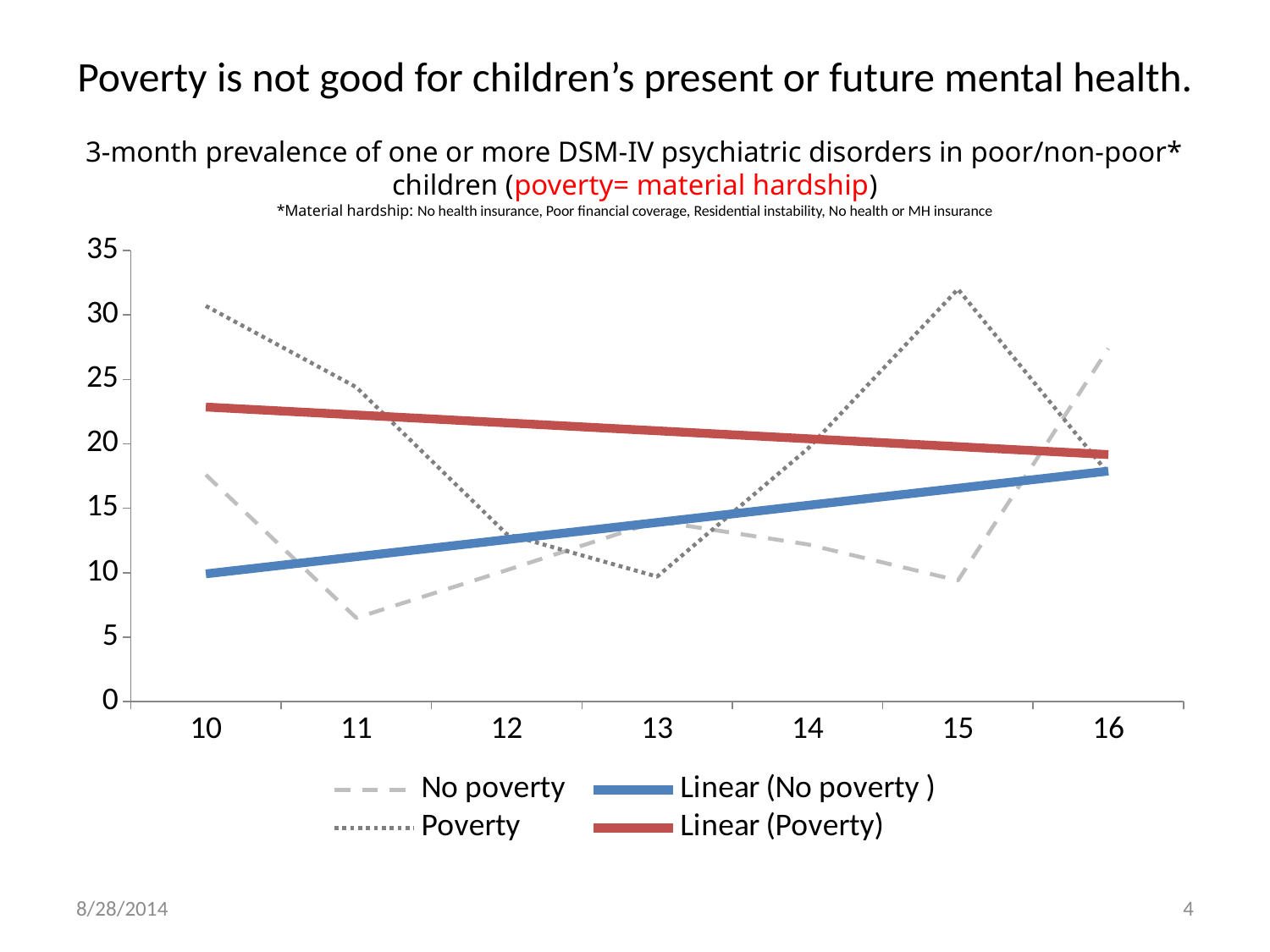
Does the Linear (No poverty) trendline rise or fall from age 10 to age 16? rise How many entries does the legend list? 4 Is the value for the Poverty series at age 10 greater or less than 30? greater What kind of chart is shown on the slide? line chart At which age does the No poverty series reach its highest value? 16 Does the Linear (Poverty) trendline rise or fall from age 10 to age 16? fall At which age does the No poverty series reach its lowest value? 11 At which age does the Poverty series reach its lowest value? 13 How many age points are plotted along the x axis? 7 Is the value for the No poverty series at age 11 greater or less than 10? less At which age does the Poverty series reach its highest value? 15 At age 10, which series has the larger value, Poverty or No poverty? Poverty